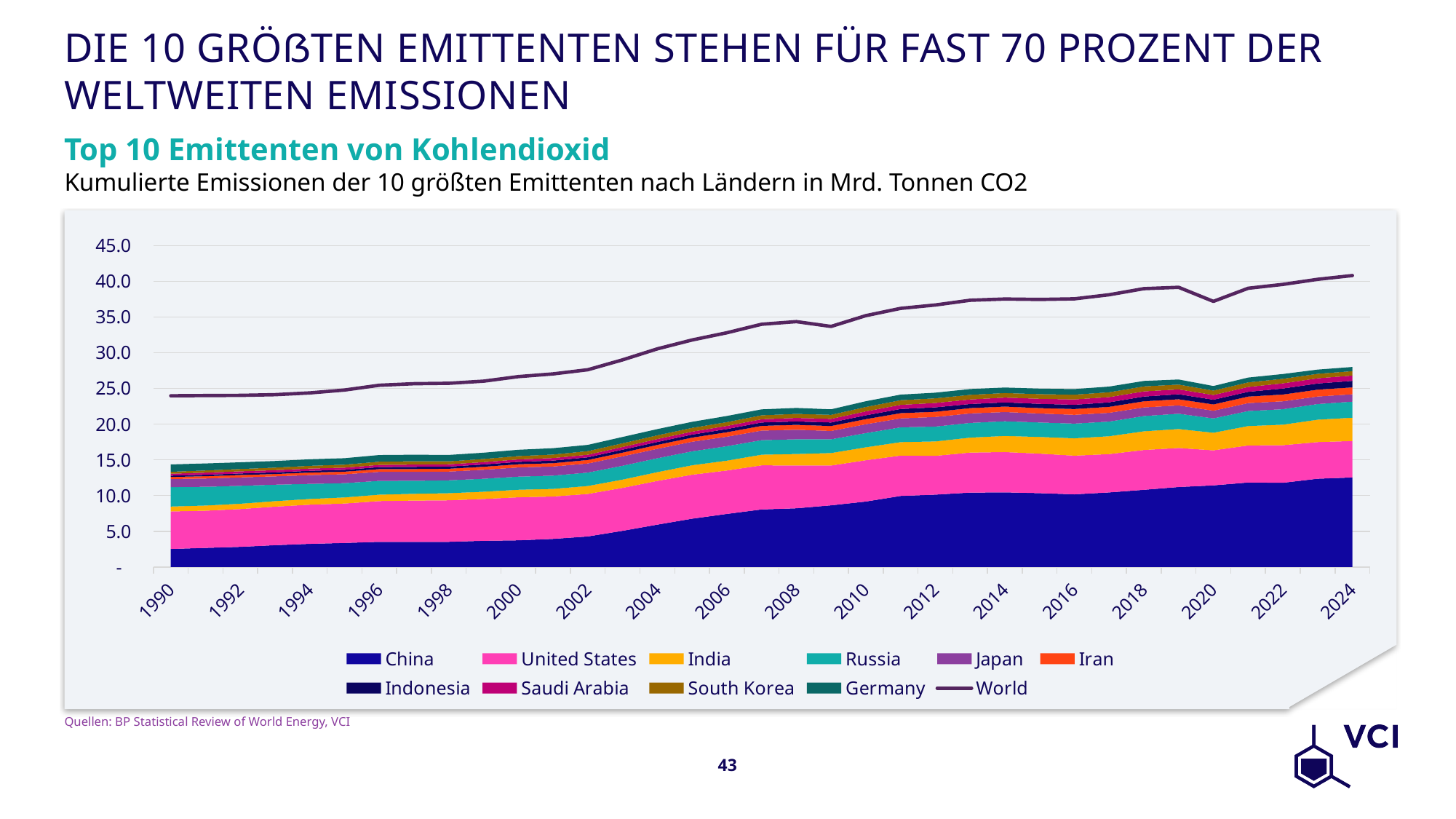
Is the total of the stacked areas in 2024 greater or less than 25.0? greater What kind of chart is shown on the slide? stacked area chart (with a line for World) Does the China area rise or fall from 1990 to 2024? rises Is the World value in 2010 greater or less than 30.0? greater What is the title of the chart? Top 10 Emittenten von Kohlendioxid Does the World line rise or fall from 1990 to 2024? rises In 1990, which is larger: the value for China or the value for United States? United States Is the value for China in 2024 greater or less than 10.0? greater Which series is drawn as a line rather than a stacked area? World How many series does the legend list? 11 Which country has the largest emissions in 2024? China